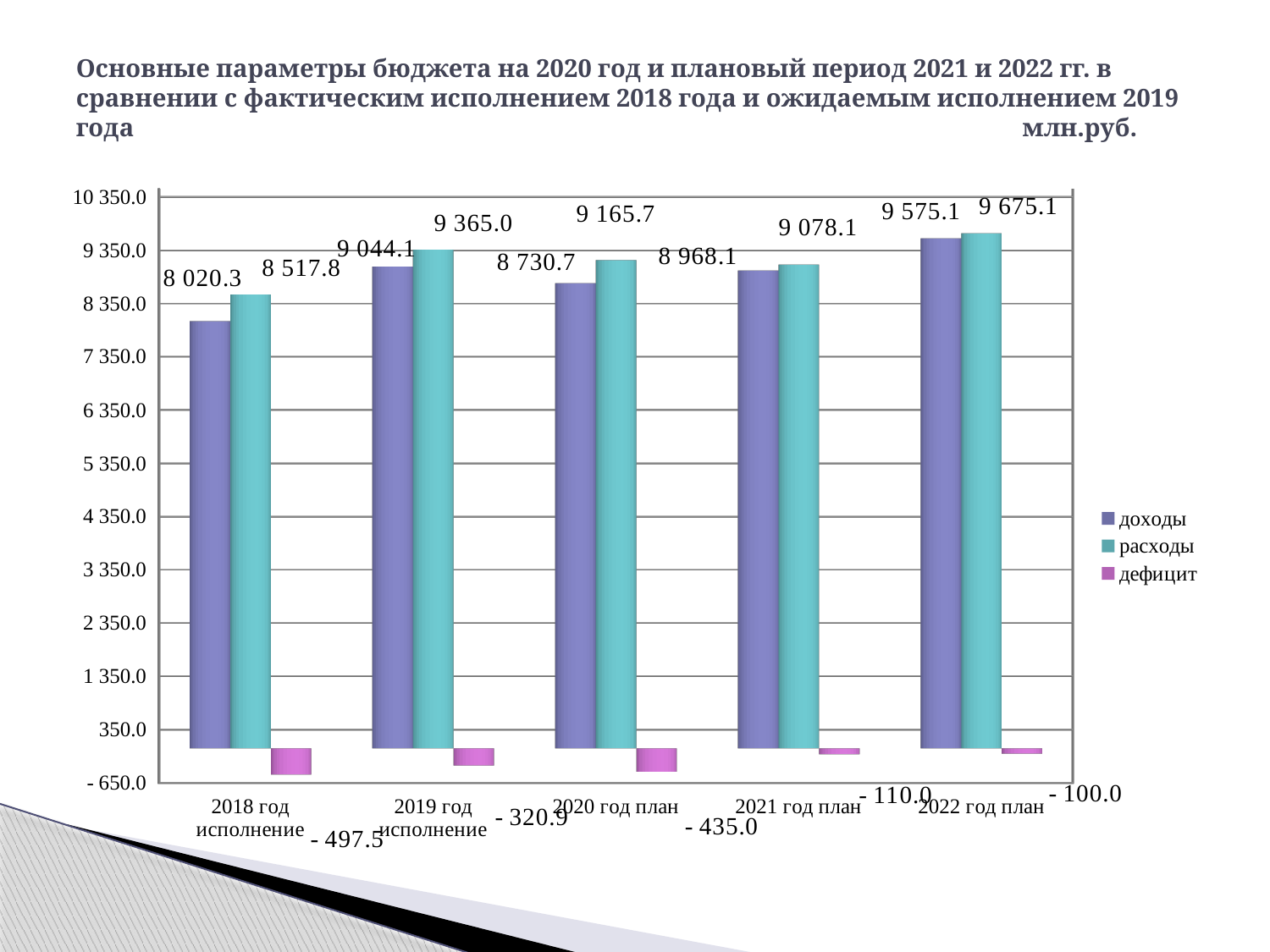
What is the value of доходы for 2018 год исполнение? 8 020.3 Which is larger: доходы for 2020 год план or доходы for 2021 год план? доходы for 2021 год план What is the value of расходы for 2020 год план? 9 165.7 What is the difference between расходы and доходы for 2019 год исполнение? 320.9 How many series does the legend list? 3 What unit is stated in the chart title? млн.руб. Does the value of дефицит for 2022 год план lie above or below the 350.0 axis line? below Which category has the highest value of расходы? 2022 год план How many categories are shown on the x axis? 5 What kind of chart is shown on the slide? bar chart Which category has the lowest value of доходы? 2018 год исполнение What is the value of дефицит for 2021 год план? - 110.0